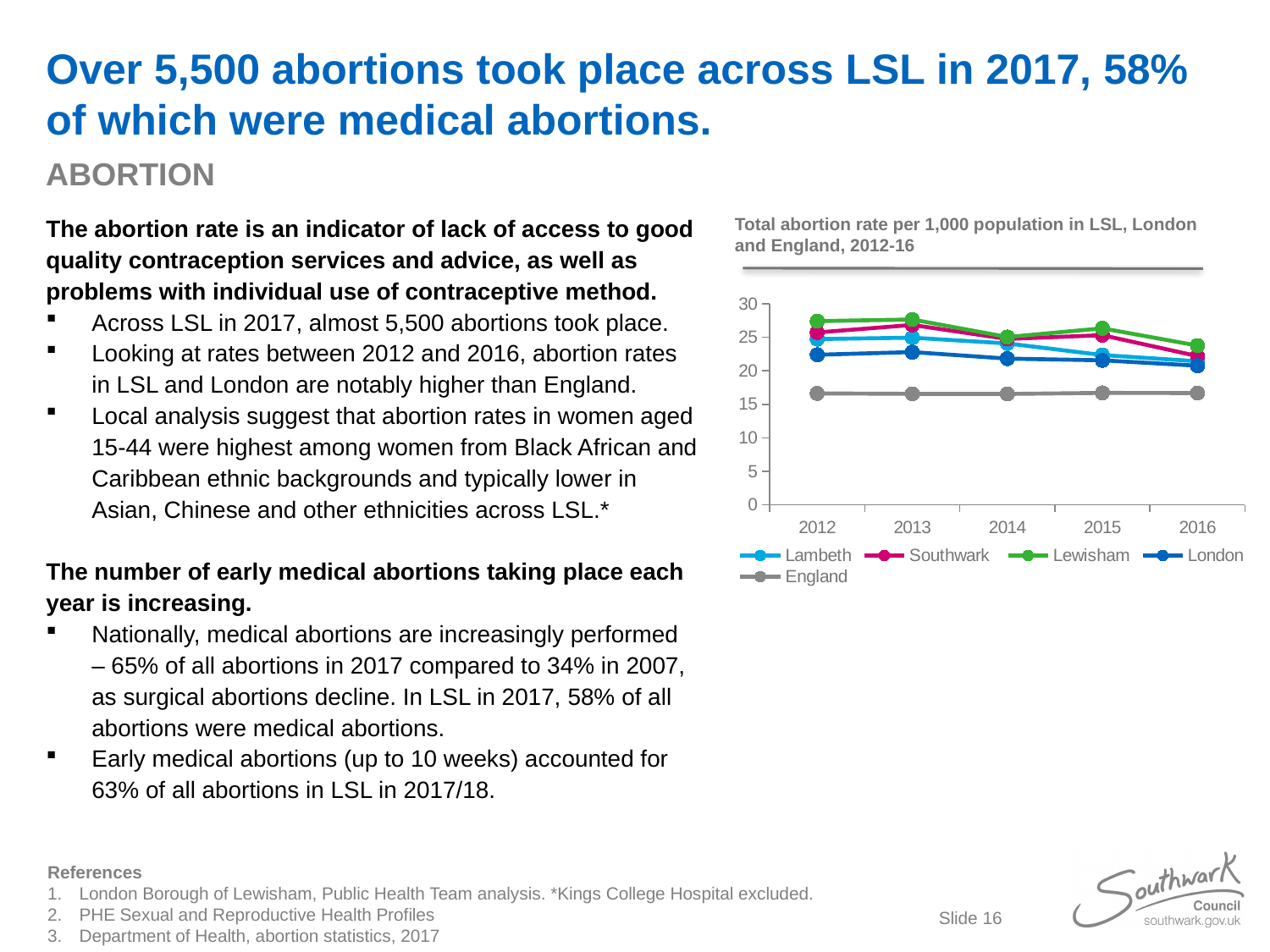
Which series has the highest abortion rate in 2012? Lewisham How many series does the legend of the chart list? 5 Is the value for England in 2014 greater or less than 20? less How many years are shown on the x axis of the chart? 5 Is the value for Lewisham in 2012 greater or less than 25? greater What kind of chart is shown on the slide? Line chart Which series has the lowest abortion rate across all years shown? England Is the value for London in 2016 greater or less than 25? less Does the Lewisham line rise or fall overall between 2012 and 2016? Fall Which series is drawn in grey on the chart? England Which is larger in 2016, the value for Lewisham or the value for England? Lewisham What is the title of the chart? Total abortion rate per 1,000 population in LSL, London and England, 2012-16